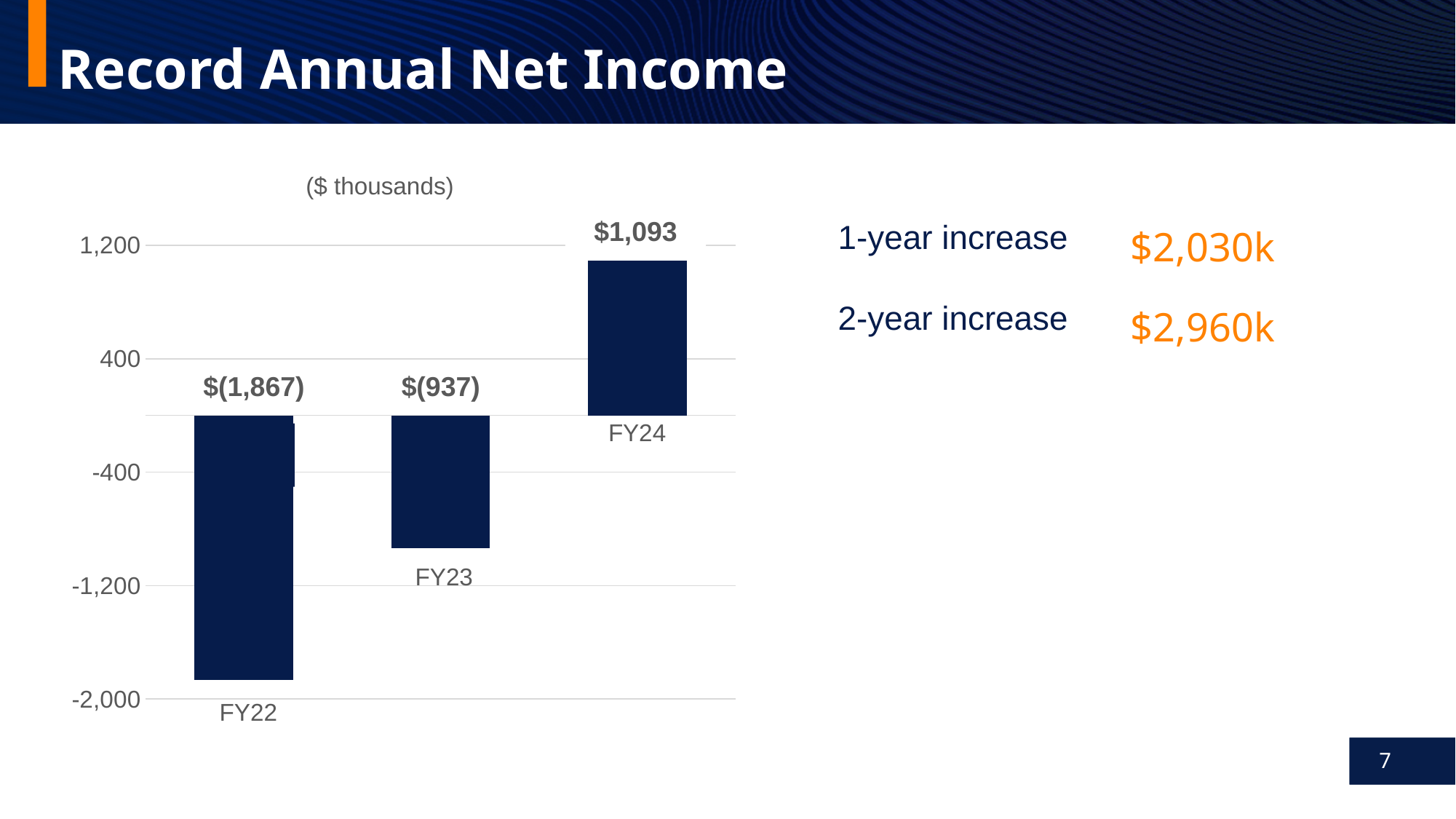
Do the net income values rise or fall from FY22 to FY24? rise What is the net income value shown for FY24? $1,093 Is the net income for FY24 greater or less than 400? greater Is the net income for FY23 greater or less than -400? less Which is larger, the net income for FY23 or FY24? FY24 In what units are the chart values expressed? $ thousands What kind of chart is shown on the slide? bar chart Which fiscal year has the lowest net income? FY22 Which fiscal year has the highest net income? FY24 What is the net income value shown for FY22? $(1,867) How many fiscal years are shown in the chart? 3 What is the net income value shown for FY23? $(937)